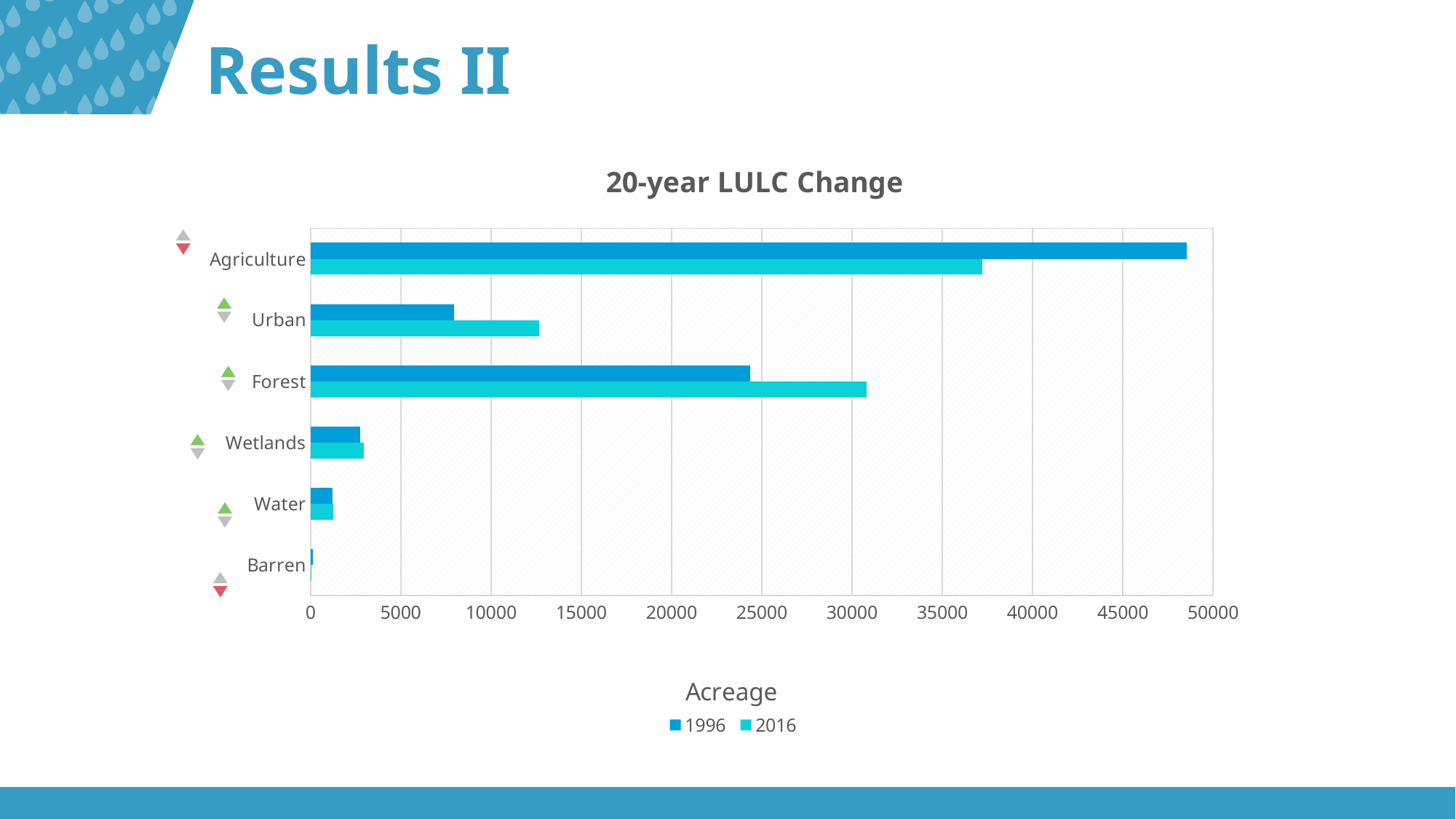
How many series does the legend list? 2 What is the title of the chart? 20-year LULC Change What type of chart is shown on the slide? bar chart For Agriculture, which year has the larger acreage, 1996 or 2016? 1996 Is the 1996 value for Agriculture greater or less than 45000? greater How many land-use categories are plotted on the chart? 6 Is the 2016 value for Urban greater or less than 10000? greater Which category has the lowest 2016 acreage? Barren Is the 1996 value for Forest greater or less than 25000? less For Forest, which year has the larger acreage, 1996 or 2016? 2016 Which category has the highest 1996 acreage? Agriculture